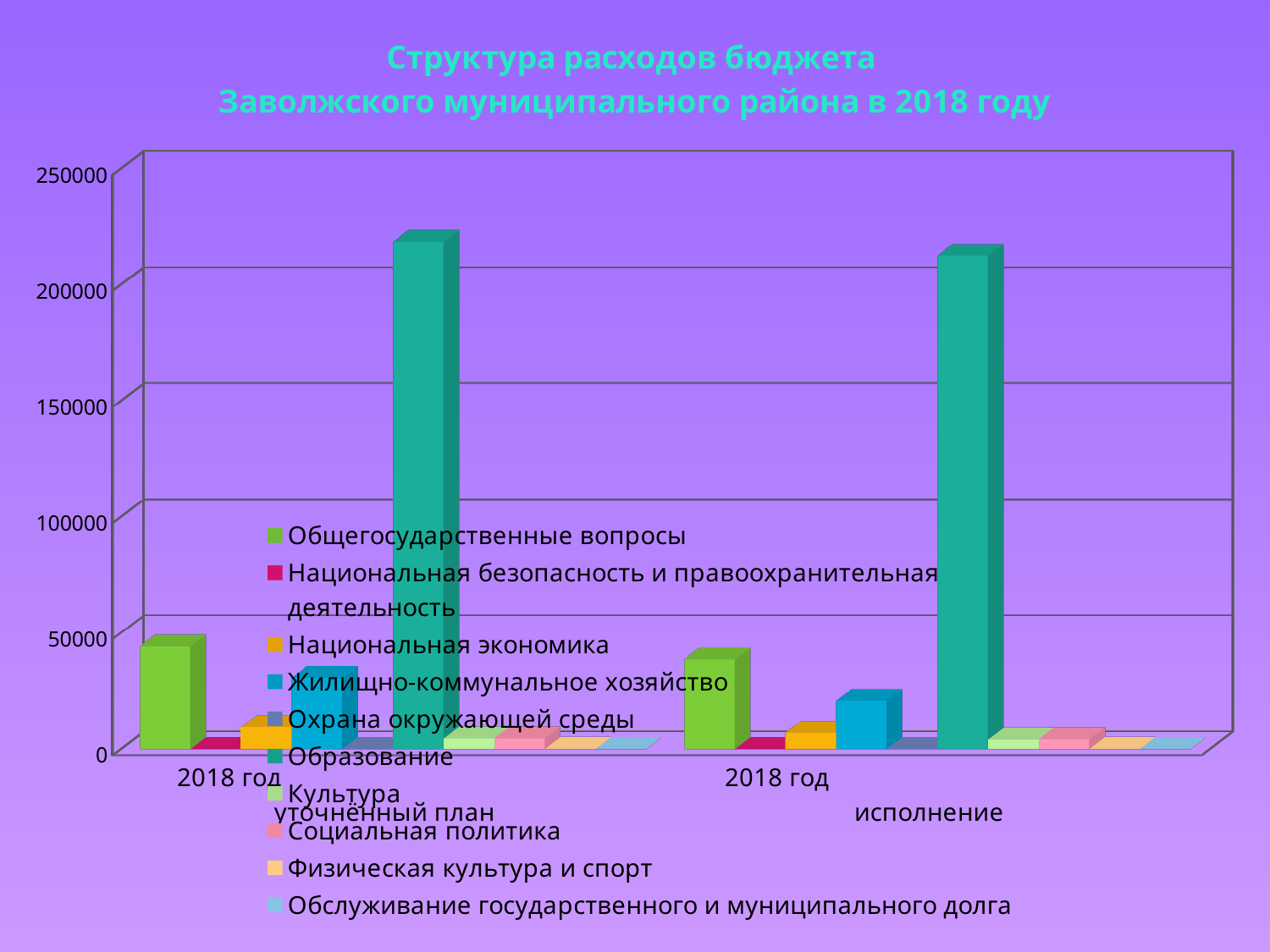
Is the value for Образование in the '2018 год уточнённый план' group greater or less than 150000? greater What is the title of the chart? Структура расходов бюджета Заволжского муниципального района в 2018 году Is the value for Общегосударственные вопросы in the '2018 год исполнение' group greater or less than 100000? less Which is larger for Образование: the '2018 год уточнённый план' value or the '2018 год исполнение' value? 2018 год уточнённый план Is the value for Образование in the '2018 год исполнение' group greater or less than 150000? greater How many series does the legend list? 10 How many category groups are shown on the x axis? 2 In the '2018 год уточнённый план' group, which is larger: Общегосударственные вопросы or Жилищно-коммунальное хозяйство? Общегосударственные вопросы What kind of chart is shown on the slide? bar chart Which series has the highest value in the '2018 год исполнение' group? Образование What is the highest value shown on the vertical axis? 250000 Which series has the highest value in the '2018 год уточнённый план' group? Образование